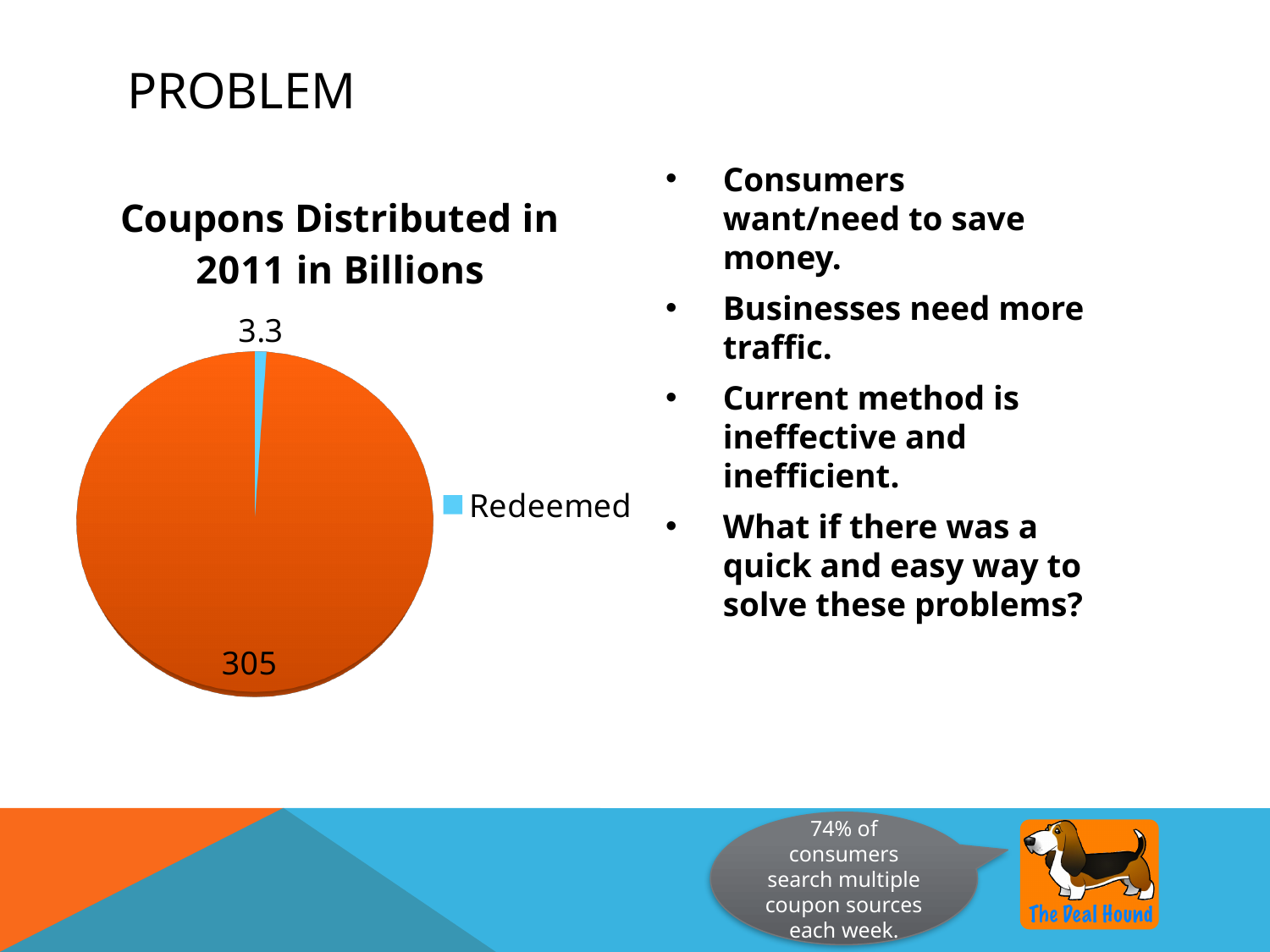
Which entry is listed in the chart legend? Redeemed Which slice of the pie chart is the smallest? Redeemed What is the title of the chart? Coupons Distributed in 2011 in Billions What value is shown for the Redeemed slice of the pie chart? 3.3 What is the value of the largest slice in the pie chart? 305 How many entries does the chart legend list? 1 What value is shown on the large orange slice of the pie chart? 305 What is the difference between the orange slice value (305) and the Redeemed value (3.3)? 301.7 Which is larger, the Redeemed slice or the orange slice? the orange slice What colour is the Redeemed slice in the pie chart? light blue How many slices does the pie chart have? 2 What type of chart is shown on the slide? pie chart